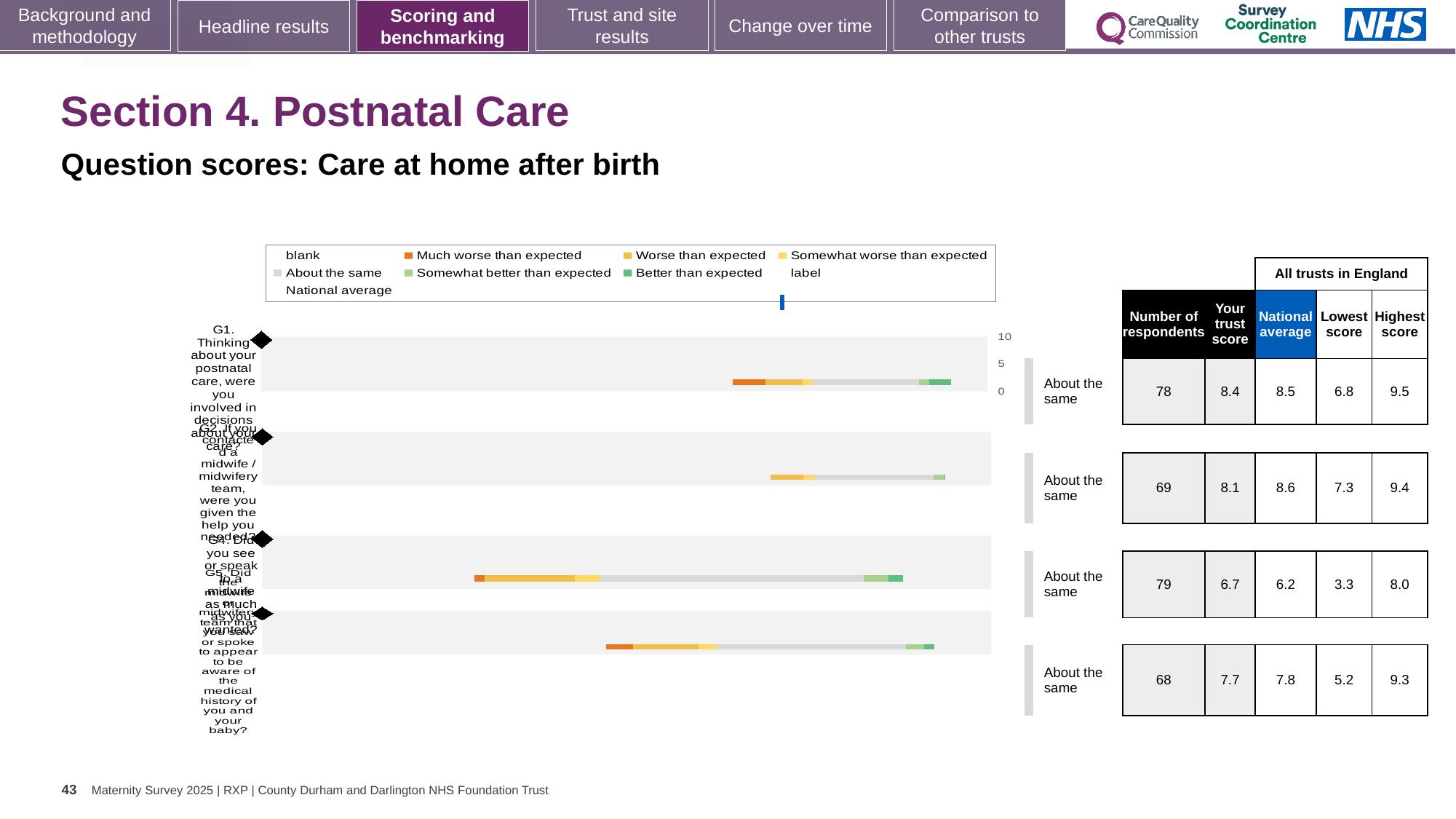
In the table beside the chart, what is the number of respondents for the second row? 69 In the table beside the chart, what is the lowest 'Lowest score' value shown? 3.3 How many question rows (bars) does the chart show? 4 In the table beside the chart, which row has the highest number of respondents? the third row (79) In the chart legend, what colour represents 'Better than expected'? green What kind of chart is shown on the slide? bar chart In the chart legend, what colour represents 'Much worse than expected'? orange In the table beside the chart, what is the difference between the highest score and lowest score in the third row? 4.7 In the table beside the chart, what is the 'Your trust score' for the fourth row? 7.7 In the table beside the chart, what is the national average for the first row (G1)? 8.5 In the table beside the chart, what is the 'Your trust score' for the first row (G1)? 8.4 In the table beside the chart, for the first row, which is larger: the trust score or the national average? national average